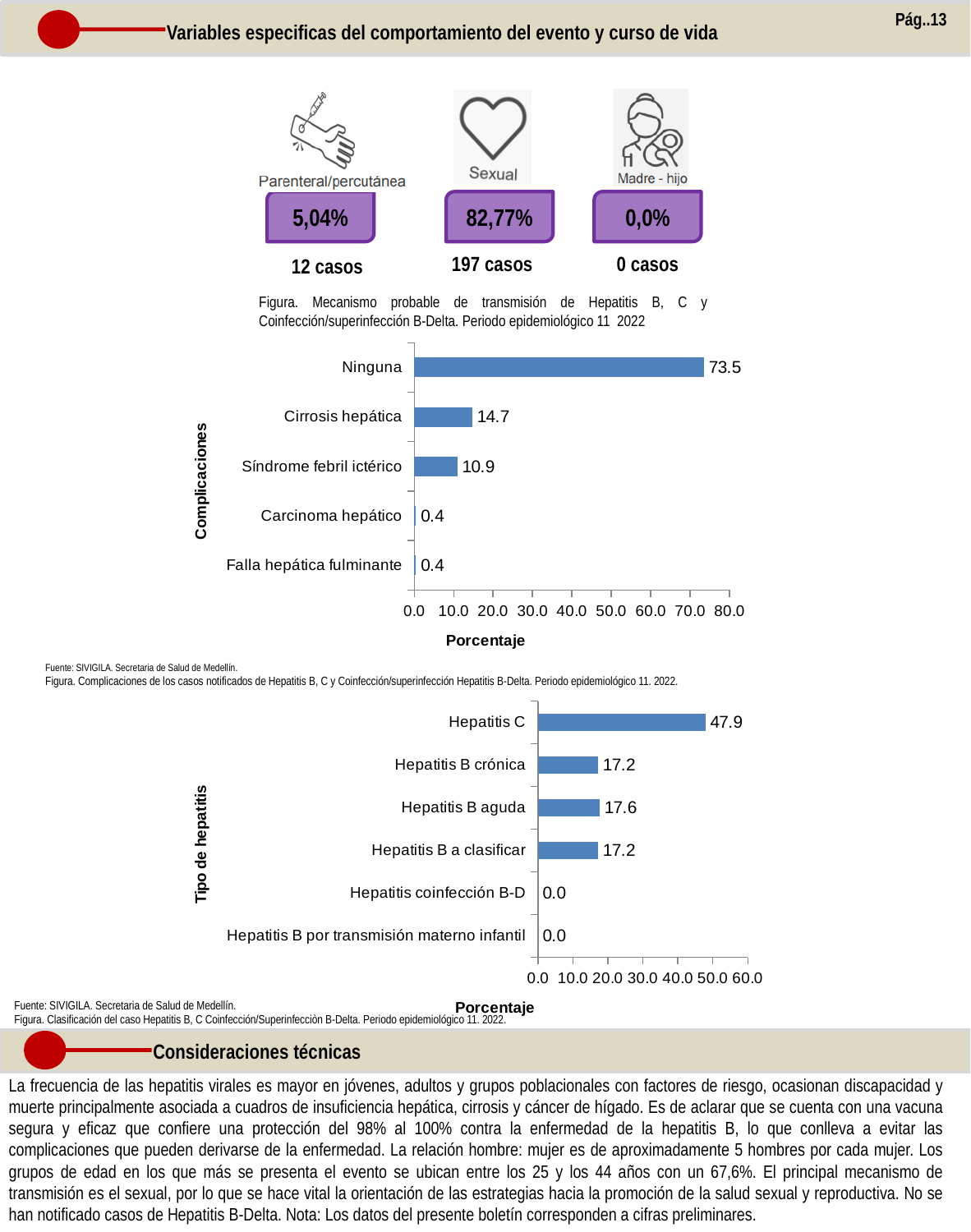
In the lower chart (Tipo de hepatitis), how many categories are shown? 6 In the lower chart (Tipo de hepatitis), what is the value for Hepatitis C? 47.9 In the lower chart (Tipo de hepatitis), what is the difference between Hepatitis C and Hepatitis B crónica? 30.7 In the upper chart (Complicaciones), which category has the highest value? Ninguna In the upper chart (Complicaciones), what is the value for Ninguna? 73.5 In the upper chart (Complicaciones), what is the difference between Cirrosis hepática and Síndrome febril ictérico? 3.8 In the lower chart (Tipo de hepatitis), which category has the highest value? Hepatitis C In the lower chart (Tipo de hepatitis), what is the value for Hepatitis B aguda? 17.6 In the upper chart (Complicaciones), what is the label of the x axis? Porcentaje In the upper chart (Complicaciones), how many categories are shown? 5 In the upper chart (Complicaciones), what is the value for Cirrosis hepática? 14.7 What type of chart is the lower chart (Tipo de hepatitis)? Bar chart